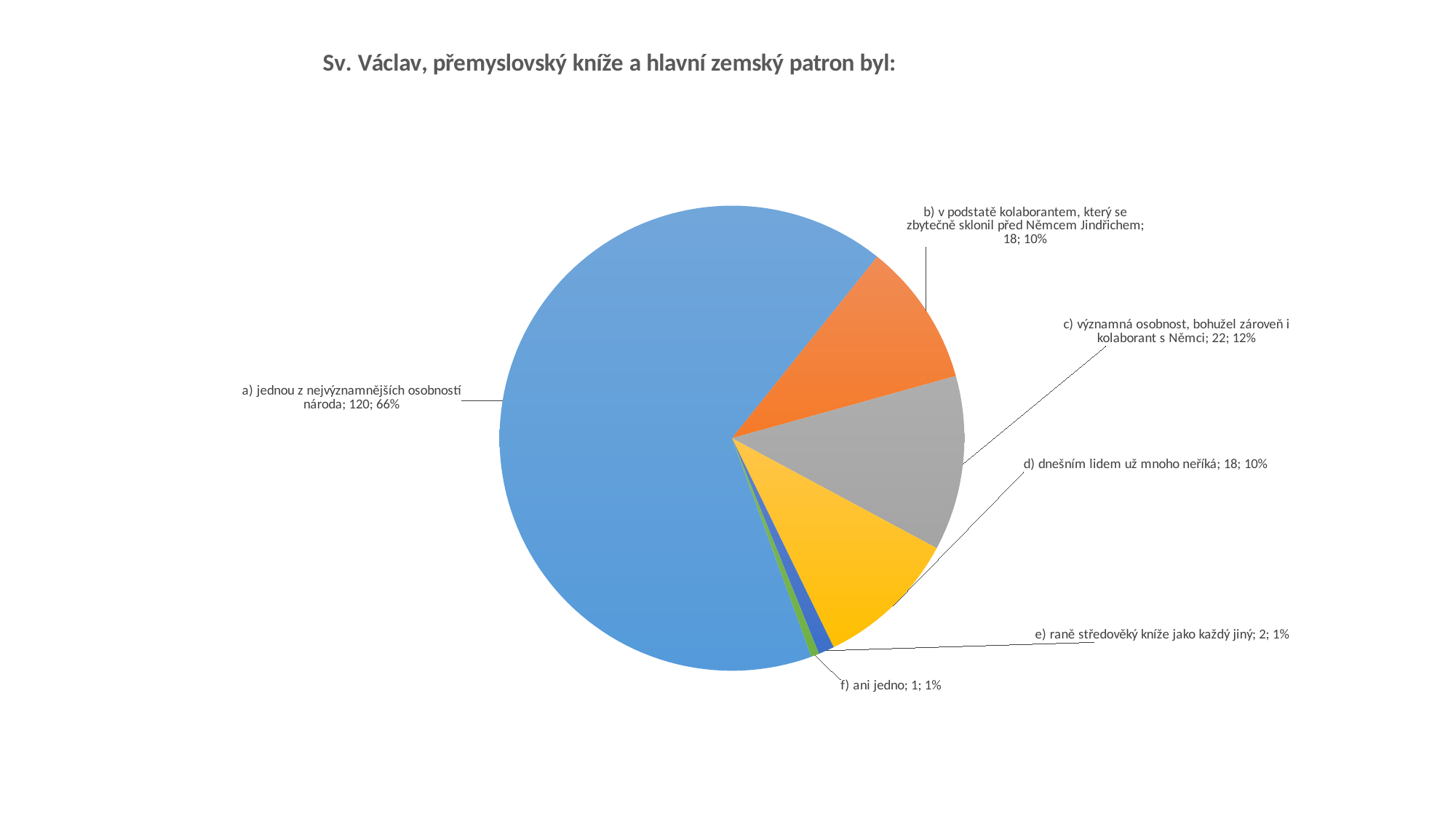
What is the title of the chart? Sv. Václav, přemyslovský kníže a hlavní zemský patron byl: Which option has the smallest slice of the pie? f) ani jedno Which has a larger value: option c) "významná osobnost, bohužel zároveň i kolaborant s Němci" or option b) "v podstatě kolaborantem"? c) významná osobnost, bohužel zároveň i kolaborant s Němci Which option has the largest slice of the pie? a) jednou z nejvýznamnějších osobností národa How many slices does the pie chart have? 6 What is the value for option a) "jednou z nejvýznamnějších osobností národa"? 120 What is the value for option f) "ani jedno"? 1 What type of chart is shown on the slide? pie chart What is the difference between the values for option a) and option c)? 98 What percentage share does option c) "významná osobnost, bohužel zároveň i kolaborant s Němci" have? 12% What percentage share does option e) "raně středověký kníže jako každý jiný" have? 1% What is the value for option d) "dnešním lidem už mnoho neříká"? 18